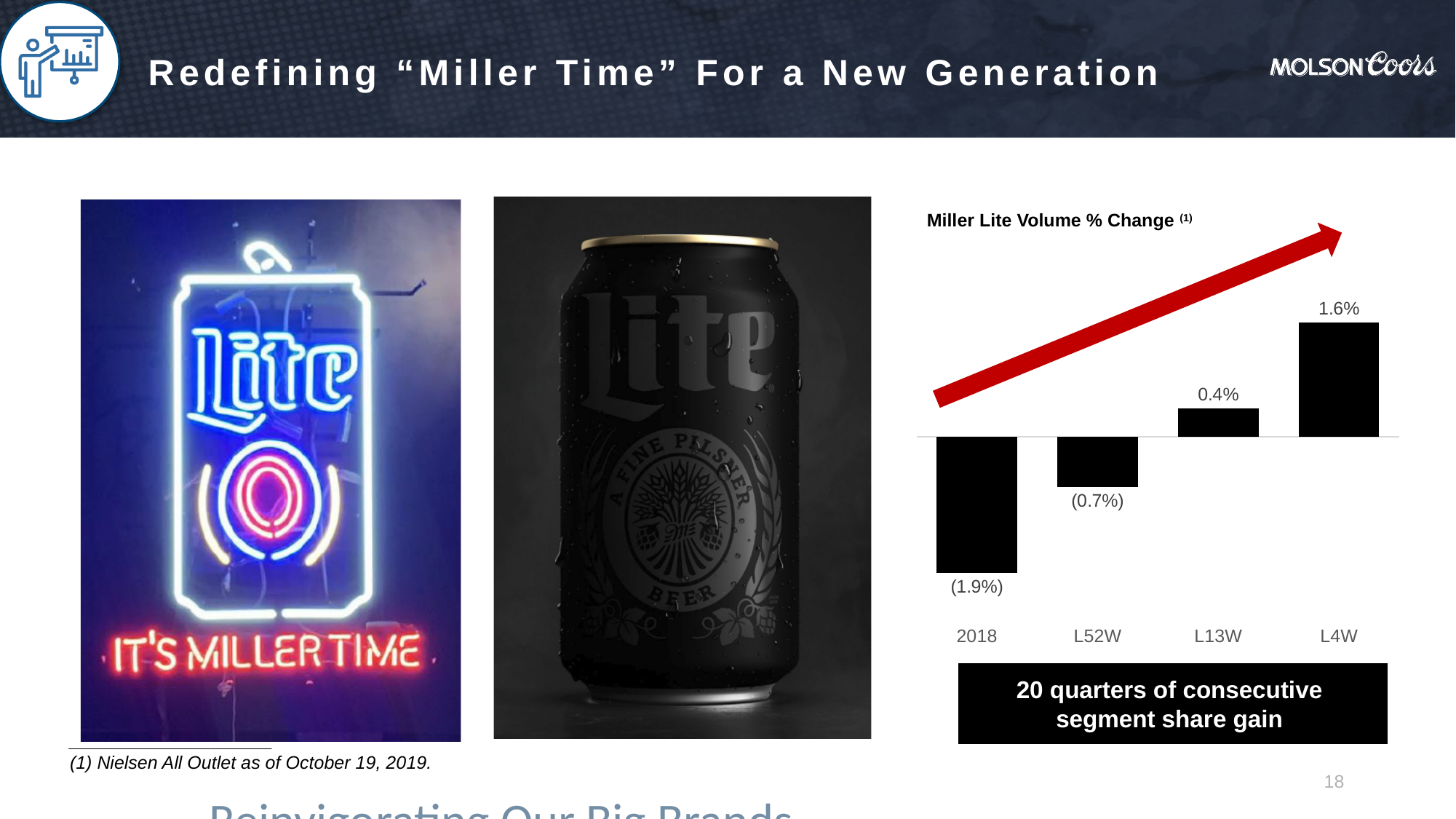
What is the Miller Lite volume % change for 2018? (1.9%) Do the values on the Miller Lite Volume % Change chart rise or fall from 2018 to L4W? Rise What is the difference between the volume % change for L4W and L13W? 1.2% What is the Miller Lite volume % change for L4W? 1.6% What is the Miller Lite volume % change for L52W? (0.7%) What is the title of the chart on the slide? Miller Lite Volume % Change Which is larger, the volume % change for L13W or for L52W? L13W Which period has the highest Miller Lite volume % change? L4W How many periods are shown on the Miller Lite Volume % Change chart? 4 Which period has the lowest Miller Lite volume % change? 2018 What is the Miller Lite volume % change for L13W? 0.4% What kind of chart is the Miller Lite Volume % Change chart? Bar chart